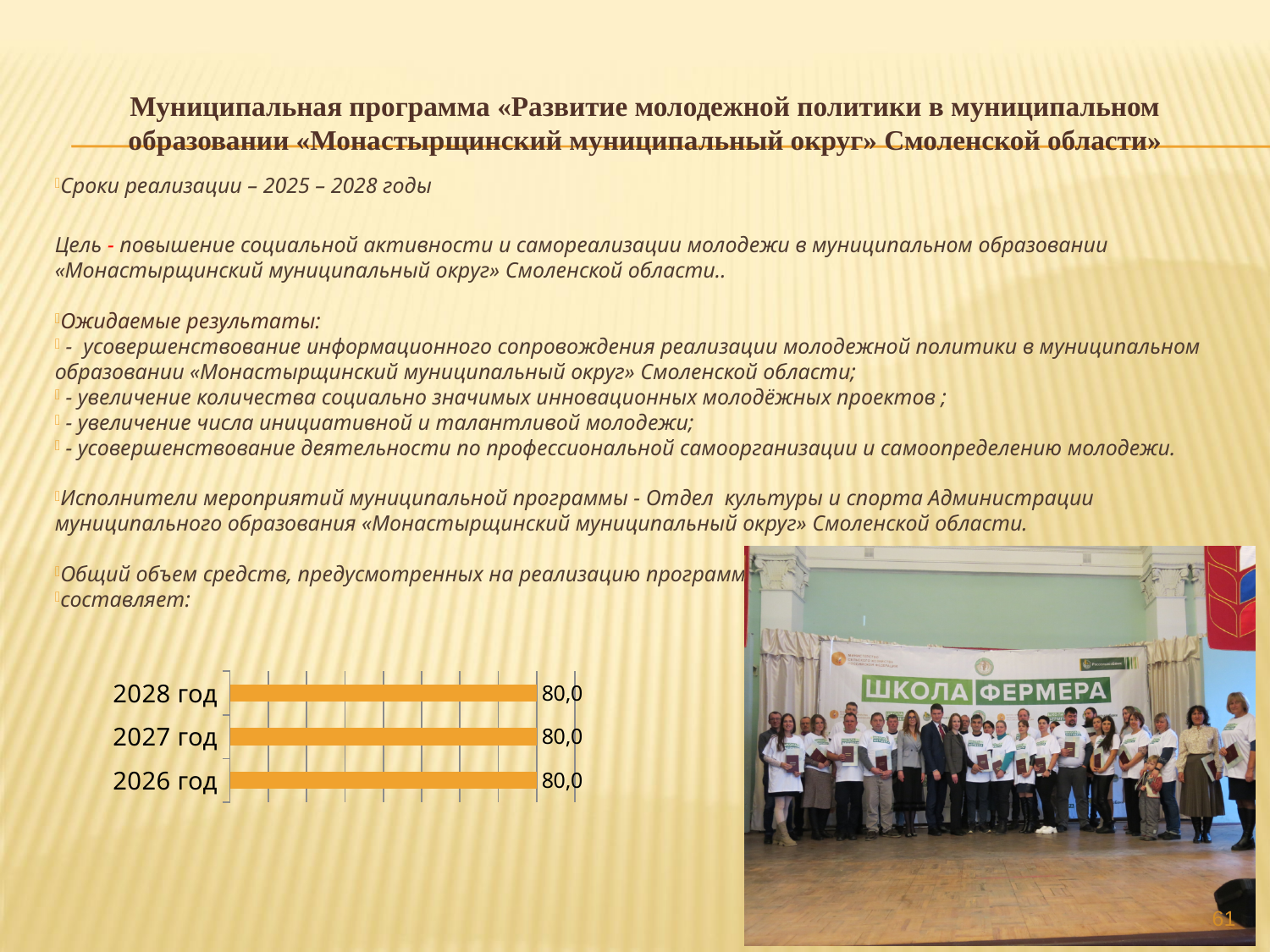
What is the value shown for 2028 год on the bar chart? 80,0 Which year is listed at the top of the bar chart? 2028 год What kind of chart is shown on the slide? bar chart What is the value shown for 2026 год on the bar chart? 80,0 Do the values on the bar chart rise, fall, or stay the same from 2026 год to 2028 год? stay the same What is the difference between the values for 2028 год and 2026 год on the bar chart? 0,0 What is the value shown for 2027 год on the bar chart? 80,0 What colour are the bars on the chart? orange Are the bars on the chart oriented horizontally or vertically? horizontally How many categories (years) are plotted on the bar chart? 3